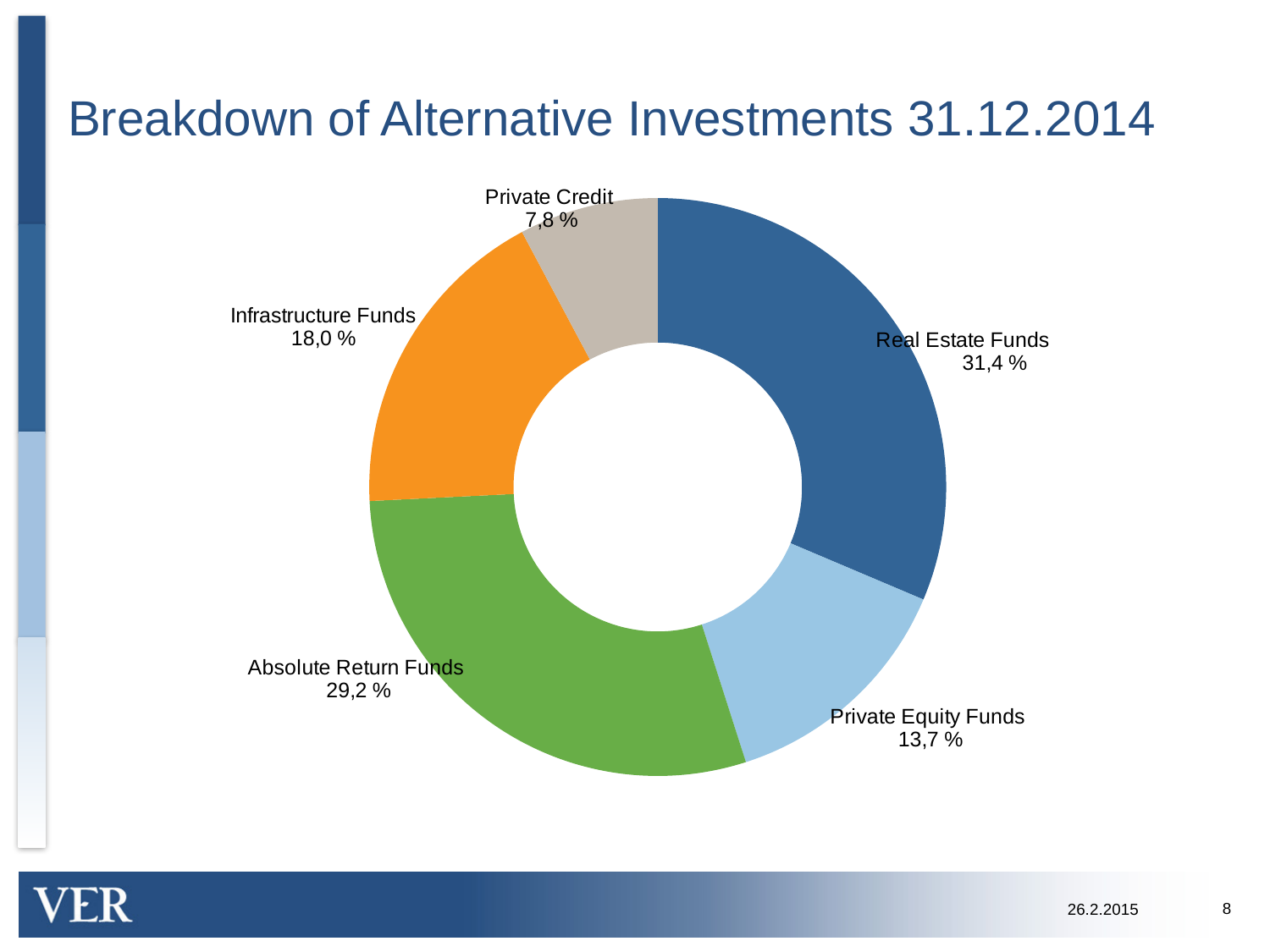
What share of alternative investments is in Private Equity Funds? 13,7 % What share of alternative investments is in Absolute Return Funds? 29,2 % What is the difference in percentage points between Infrastructure Funds and Private Credit? 10,2 How many categories are shown in the chart? 5 What share of alternative investments is in Infrastructure Funds? 18,0 % What share of alternative investments is in Real Estate Funds? 31,4 % Which has a larger share, Absolute Return Funds or Infrastructure Funds? Absolute Return Funds Which category has the smallest share of alternative investments? Private Credit What is the difference in percentage points between Real Estate Funds and Private Equity Funds? 17,7 Which category has the largest share of alternative investments? Real Estate Funds What share of alternative investments is in Private Credit? 7,8 % What type of chart is shown on the slide? Doughnut (pie) chart